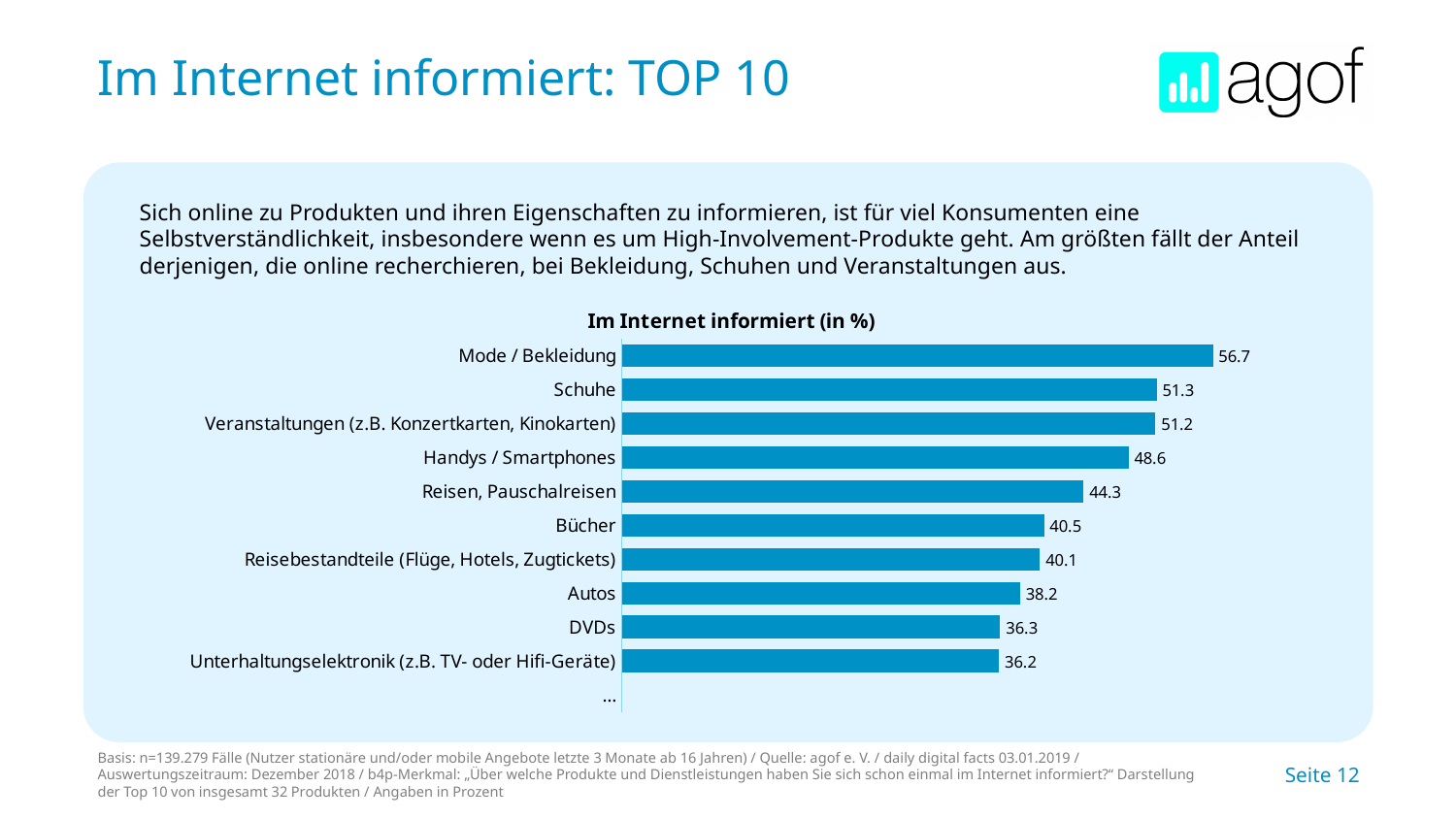
What is the title of the chart? Im Internet informiert (in %) What is the difference between the values for Bücher and DVDs? 4.2 What is the value for Reisebestandteile (Flüge, Hotels, Zugtickets)? 40.1 Which is larger, the value for Handys / Smartphones or the value for Reisen, Pauschalreisen? Handys / Smartphones What is the value for Reisen, Pauschalreisen? 44.3 What is the difference between the values for Mode / Bekleidung and Schuhe? 5.4 What is the value for Autos? 38.2 Which category has the lowest value among the ten shown? Unterhaltungselektronik (z.B. TV- oder Hifi-Geräte) What kind of chart is shown on the slide? Bar chart How many categories with values are shown in the chart? 10 What is the value for Mode / Bekleidung? 56.7 Which category has the highest value? Mode / Bekleidung